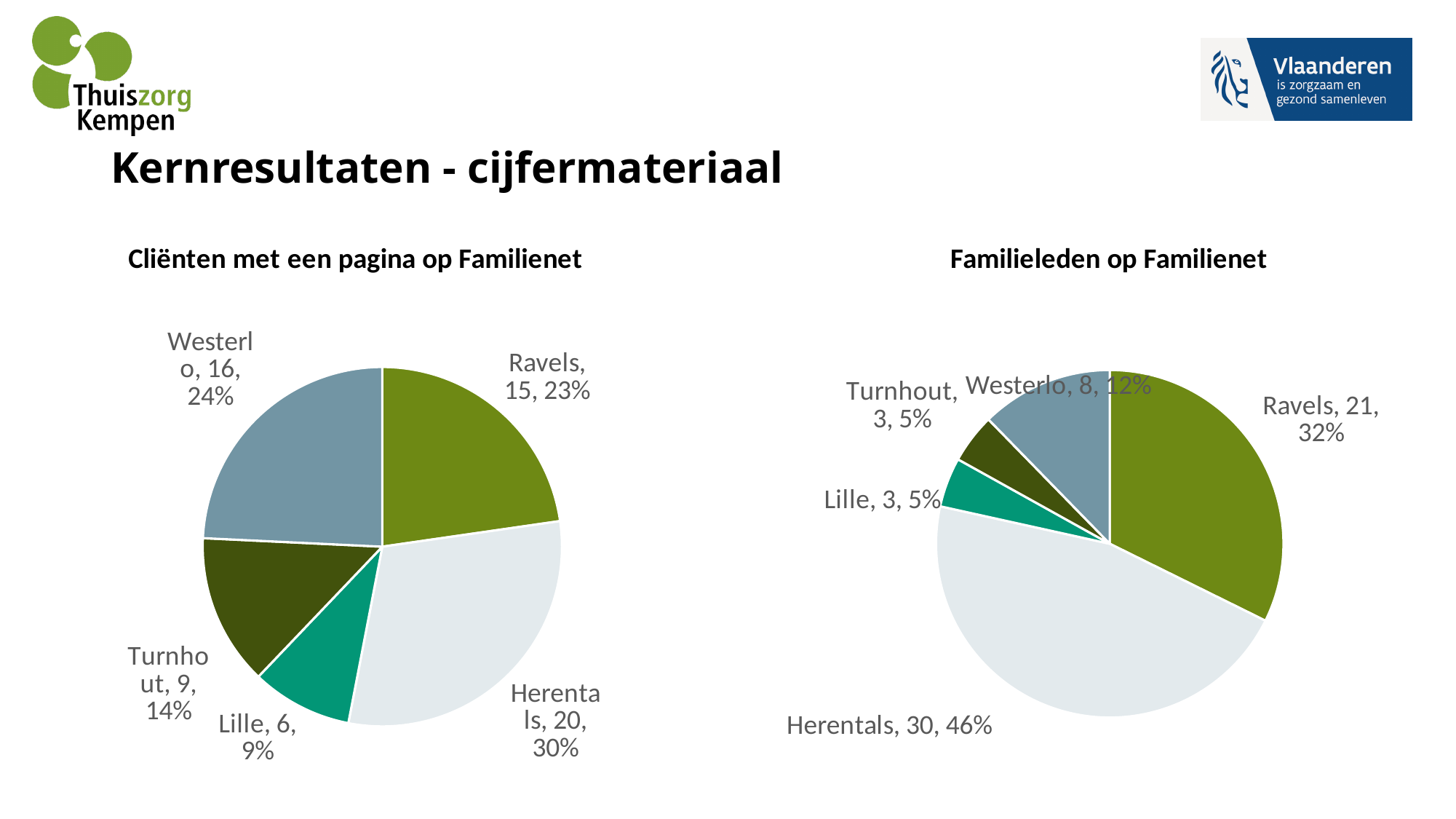
In the 'Familieleden op Familienet' chart, what is the value for Ravels? 21 In the 'Cliënten met een pagina op Familienet' chart, which category has the highest value? Herentals How many categories are shown in the 'Familieleden op Familienet' chart? 5 In the 'Cliënten met een pagina op Familienet' chart, which category has the lowest value? Lille In the 'Familieleden op Familienet' chart, which category has the highest value? Herentals In the 'Cliënten met een pagina op Familienet' chart, what share of the pie does Turnhout represent? 14% In the 'Cliënten met een pagina op Familienet' chart, which is larger, the value for Westerlo or the value for Ravels? Westerlo In the 'Cliënten met een pagina op Familienet' chart, what is the value for Herentals? 20 In the 'Familieleden op Familienet' chart, what share of the pie does Westerlo represent? 12% What is the title of the chart on the right side of the slide? Familieleden op Familienet What kind of chart is the 'Cliënten met een pagina op Familienet' chart? Pie chart In the 'Familieleden op Familienet' chart, what is the difference between the values for Herentals and Ravels? 9